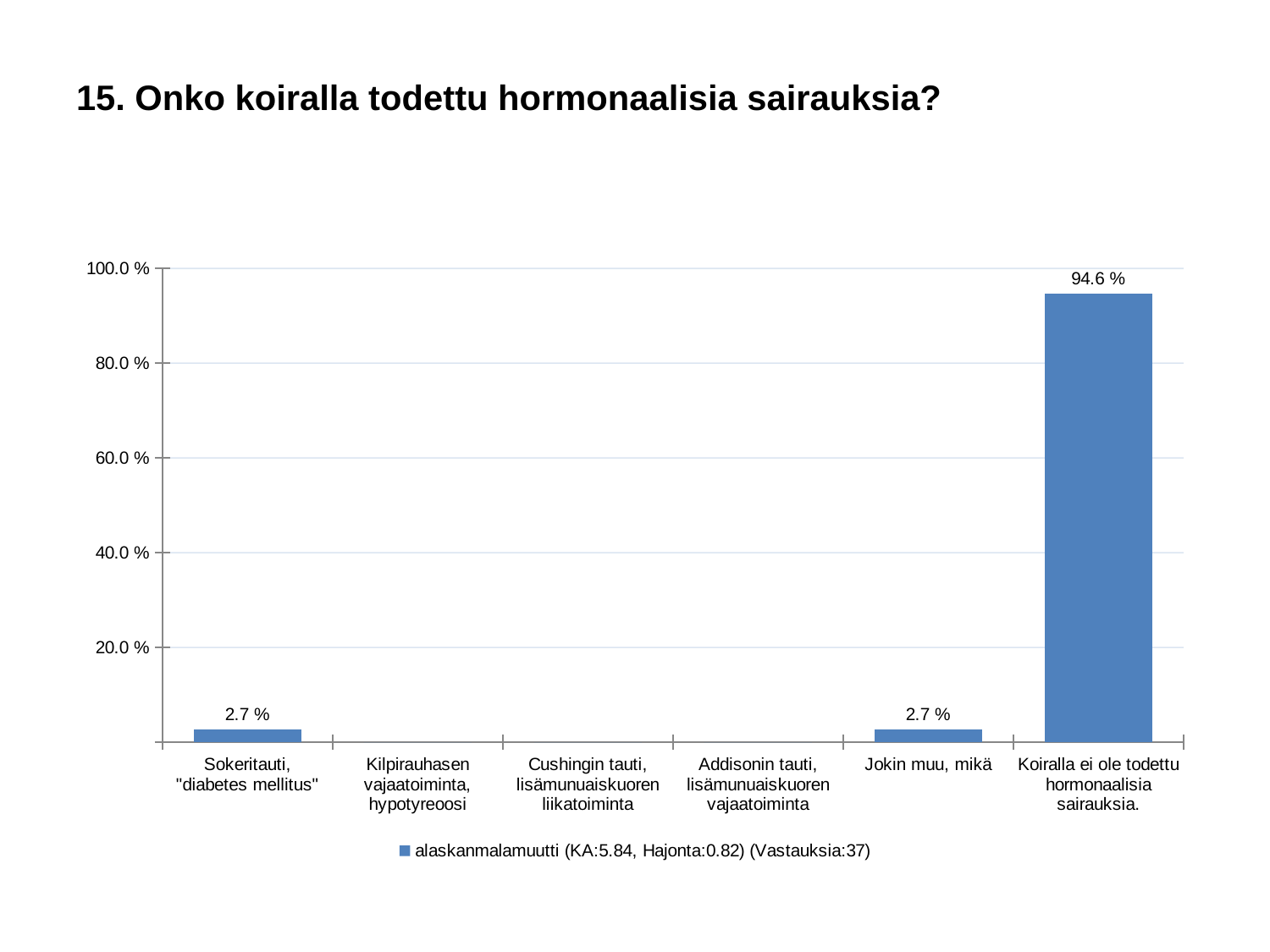
What is the title of the chart? 15. Onko koiralla todettu hormonaalisia sairauksia? What is the difference between the values for "Koiralla ei ole todettu hormonaalisia sairauksia." and "Jokin muu, mikä"? 91.9 % Which is larger, the value for "Koiralla ei ole todettu hormonaalisia sairauksia." or the value for "Sokeritauti, "diabetes mellitus""? Koiralla ei ole todettu hormonaalisia sairauksia. Which category has the highest value? Koiralla ei ole todettu hormonaalisia sairauksia. Is the value for "Koiralla ei ole todettu hormonaalisia sairauksia." greater or less than 80.0 %? greater What is the value for "Koiralla ei ole todettu hormonaalisia sairauksia."? 94.6 % How many series does the legend list? 1 Is the value for "Sokeritauti, "diabetes mellitus"" greater or less than 20.0 %? less What is the value for "Sokeritauti, "diabetes mellitus""? 2.7 % What is the value for "Jokin muu, mikä"? 2.7 % What kind of chart is shown on the slide? bar chart How many categories are shown on the x axis? 6